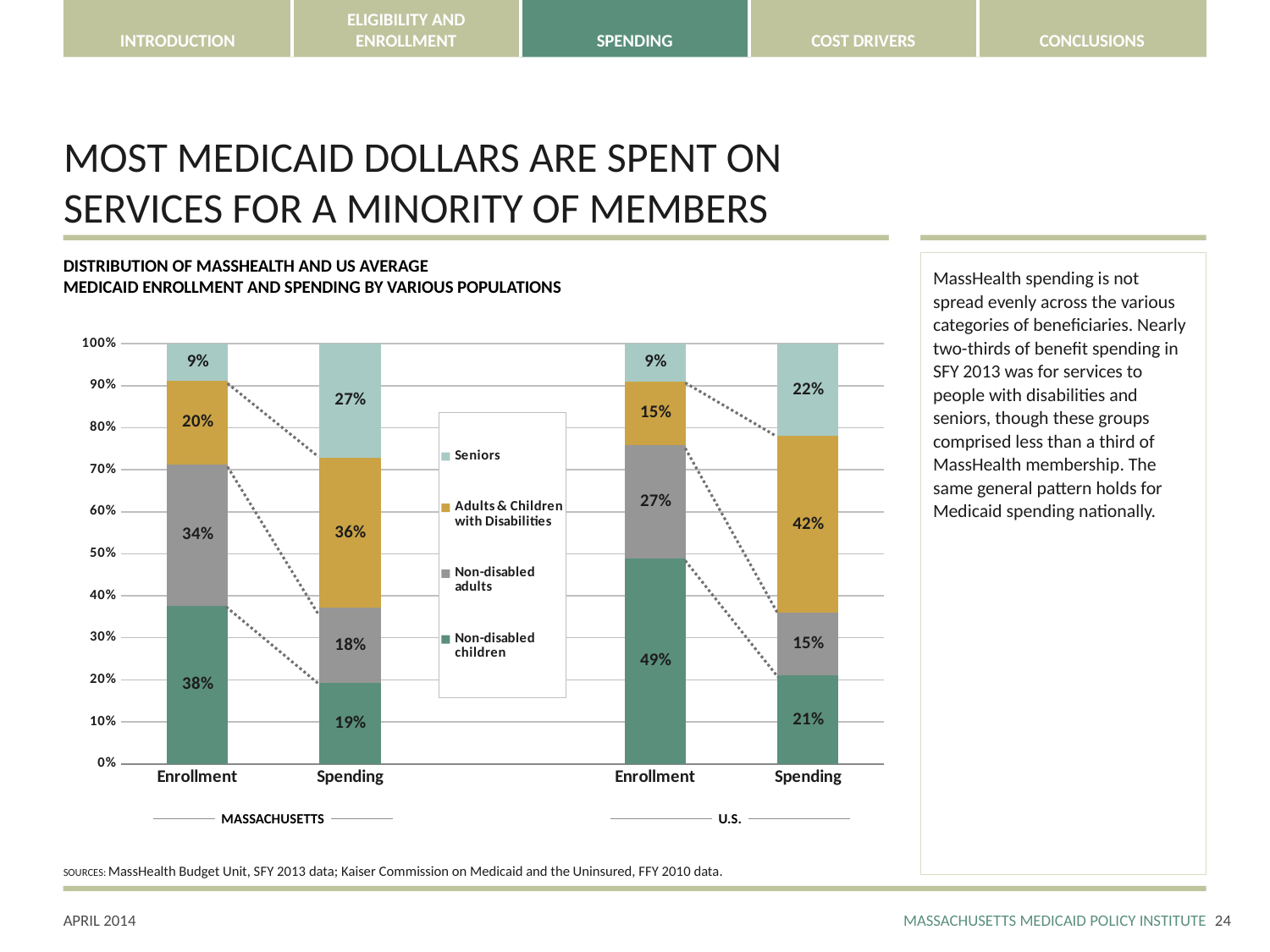
How many stacked bars are shown in the chart? 4 Which population has the largest share of U.S. Medicaid spending? Adults & Children with Disabilities What share of Massachusetts Medicaid enrollment is non-disabled children? 38% What share of U.S. Medicaid enrollment is non-disabled adults? 27% What share of Massachusetts Medicaid spending goes to adults & children with disabilities? 36% How much larger is the seniors' share of Massachusetts spending than their share of Massachusetts enrollment? 18 percentage points Which population has the smallest share of Massachusetts Medicaid enrollment? Seniors What share of U.S. Medicaid spending goes to seniors? 22% Which is larger: the non-disabled children share of U.S. enrollment or of U.S. spending? U.S. enrollment How many series does the legend list? 4 What type of chart is shown on the slide? Stacked bar chart What is the combined share of Massachusetts spending for seniors and adults & children with disabilities? 63%